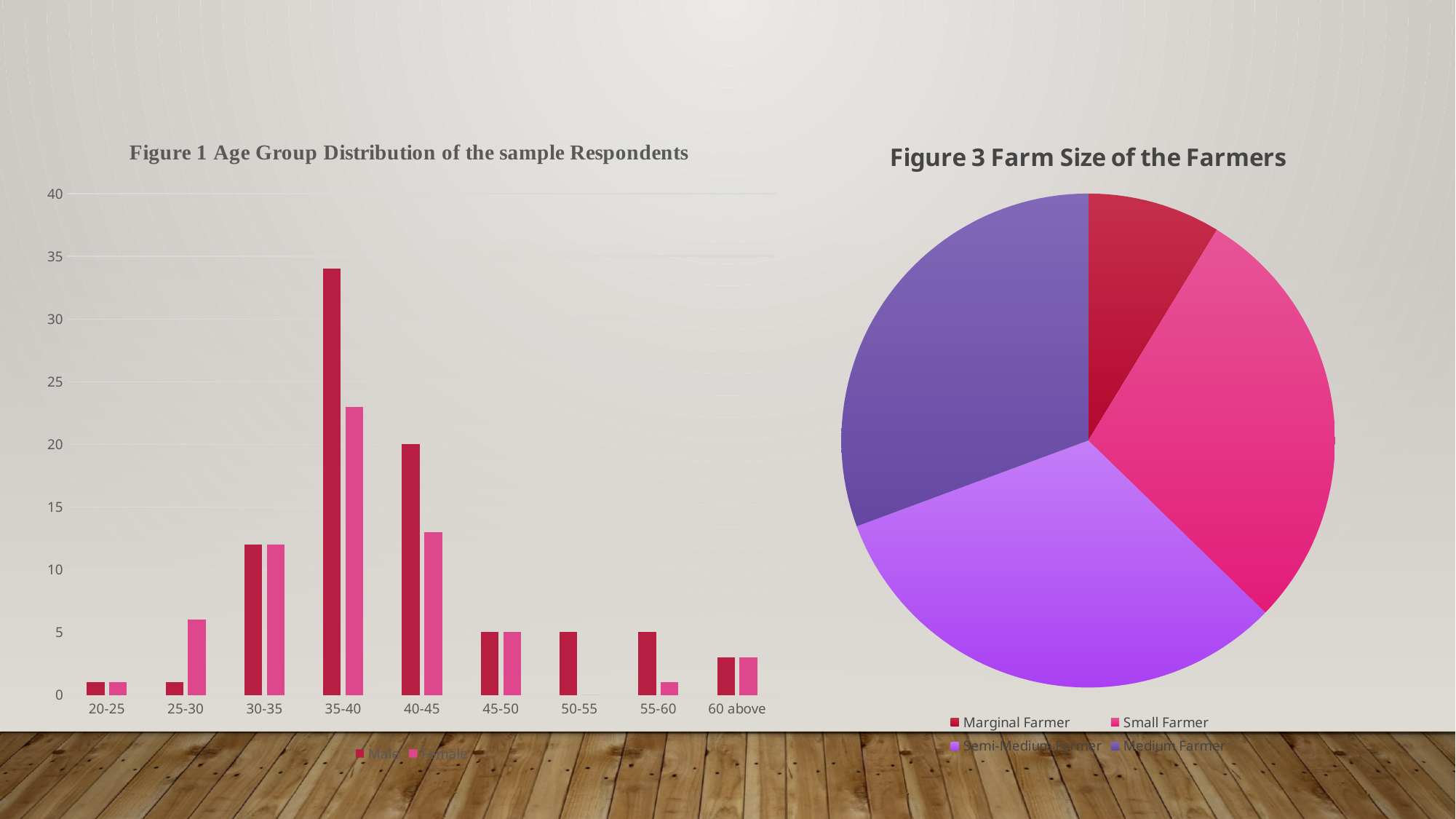
In Figure 1 Age Group Distribution of the sample Respondents, what is the Male value for 45-50? 5 What kind of chart is Figure 3 Farm Size of the Farmers? pie chart In Figure 1 Age Group Distribution of the sample Respondents, how many age group categories are shown on the x axis? 9 In Figure 1 Age Group Distribution of the sample Respondents, how many series does the legend list? 2 What kind of chart is Figure 1 Age Group Distribution of the sample Respondents? bar chart In Figure 3 Farm Size of the Farmers, which category has the smallest slice? Marginal Farmer In Figure 3 Farm Size of the Farmers, how many slices does the pie have? 4 In Figure 1 Age Group Distribution of the sample Respondents, which age group has the highest Male value? 35-40 In Figure 1 Age Group Distribution of the sample Respondents, which is larger for the 25-30 age group, the Male value or the Female value? Female In Figure 1 Age Group Distribution of the sample Respondents, which age group has the highest Female value? 35-40 In Figure 1 Age Group Distribution of the sample Respondents, what is the Male value for 40-45? 20 In Figure 1 Age Group Distribution of the sample Respondents, is the Male value for 35-40 greater or less than 30? greater